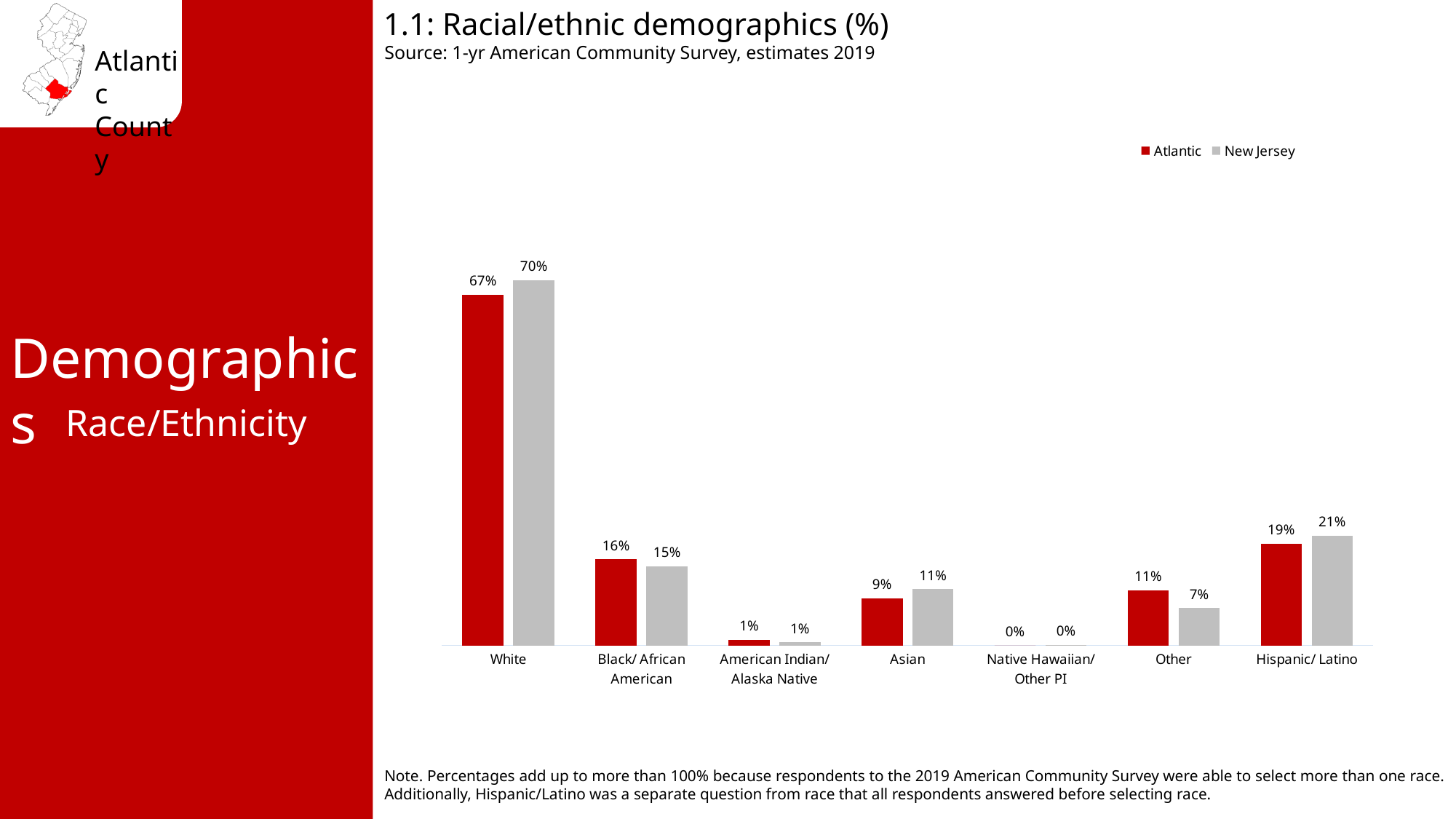
What is the difference between the Atlantic and New Jersey values for Other? 4% Which category has the lowest New Jersey value? Native Hawaiian/ Other PI How many series does the legend list? 2 What is the Atlantic value for Other? 11% Which is larger for Black/ African American: the Atlantic value or the New Jersey value? Atlantic What is the Atlantic value for White? 67% What kind of chart is shown? Bar chart What is the difference between the New Jersey and Atlantic values for White? 3% What is the New Jersey value for Hispanic/ Latino? 21% Which category has the highest Atlantic value? White What is the New Jersey value for Asian? 11% How many categories are shown on the x axis? 7